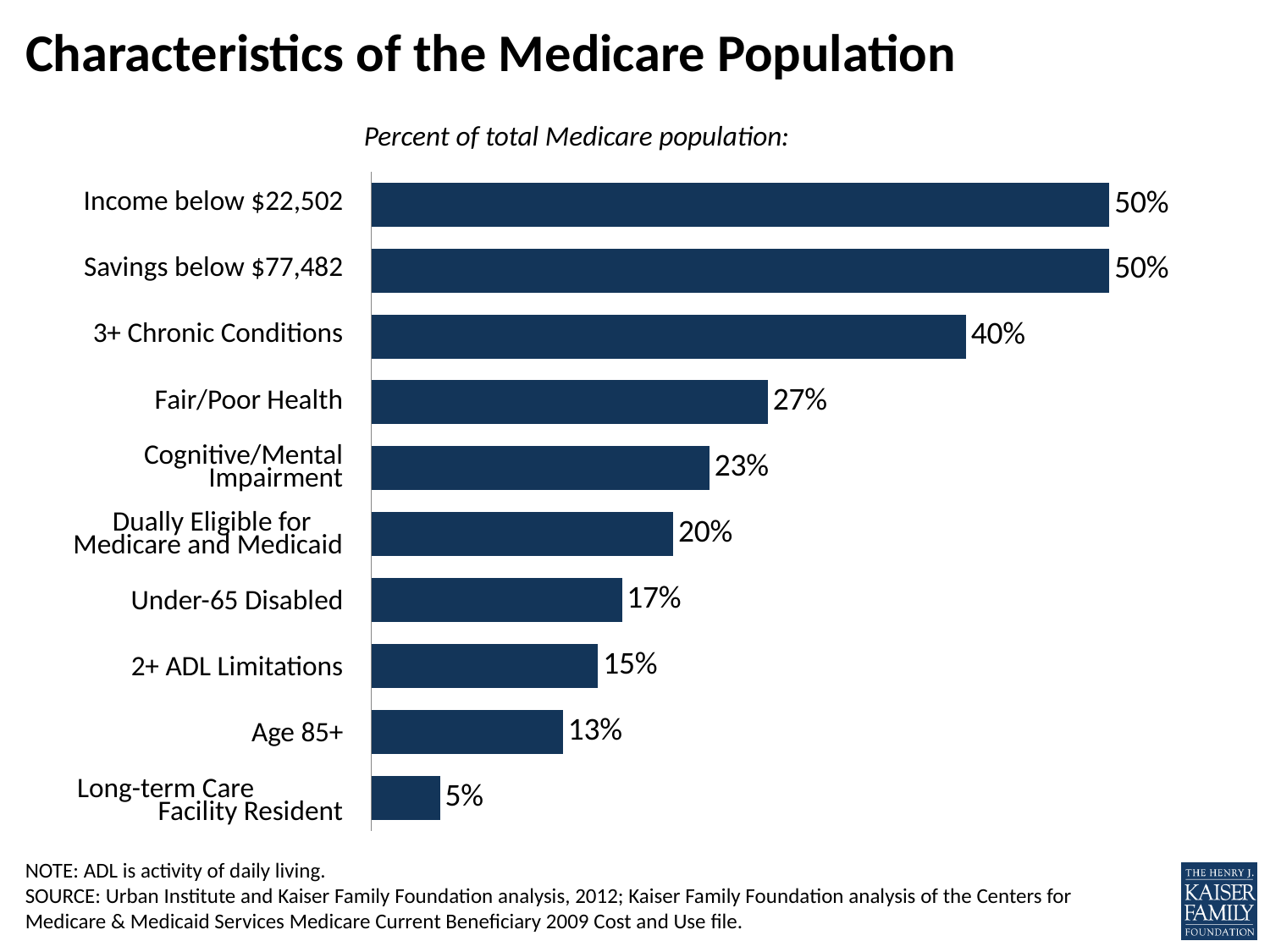
What percent of the Medicare population is a long-term care facility resident? 5% Which is larger, the value for Dually Eligible for Medicare and Medicaid or the value for 2+ ADL Limitations? Dually Eligible for Medicare and Medicaid Which category has the lowest value? Long-term Care Facility Resident What kind of chart is shown on the slide? Bar chart What percent of the Medicare population has 3+ chronic conditions? 40% What is the value for Savings below $77,482? 50% How many categories are shown in the chart? 10 What is the value for Fair/Poor Health? 27% What is the value for Under-65 Disabled? 17% What is the subtitle shown above the chart? Percent of total Medicare population: What is the difference between the values for Cognitive/Mental Impairment and Age 85+? 10% What is the difference between the values for Income below $22,502 and 3+ Chronic Conditions? 10%